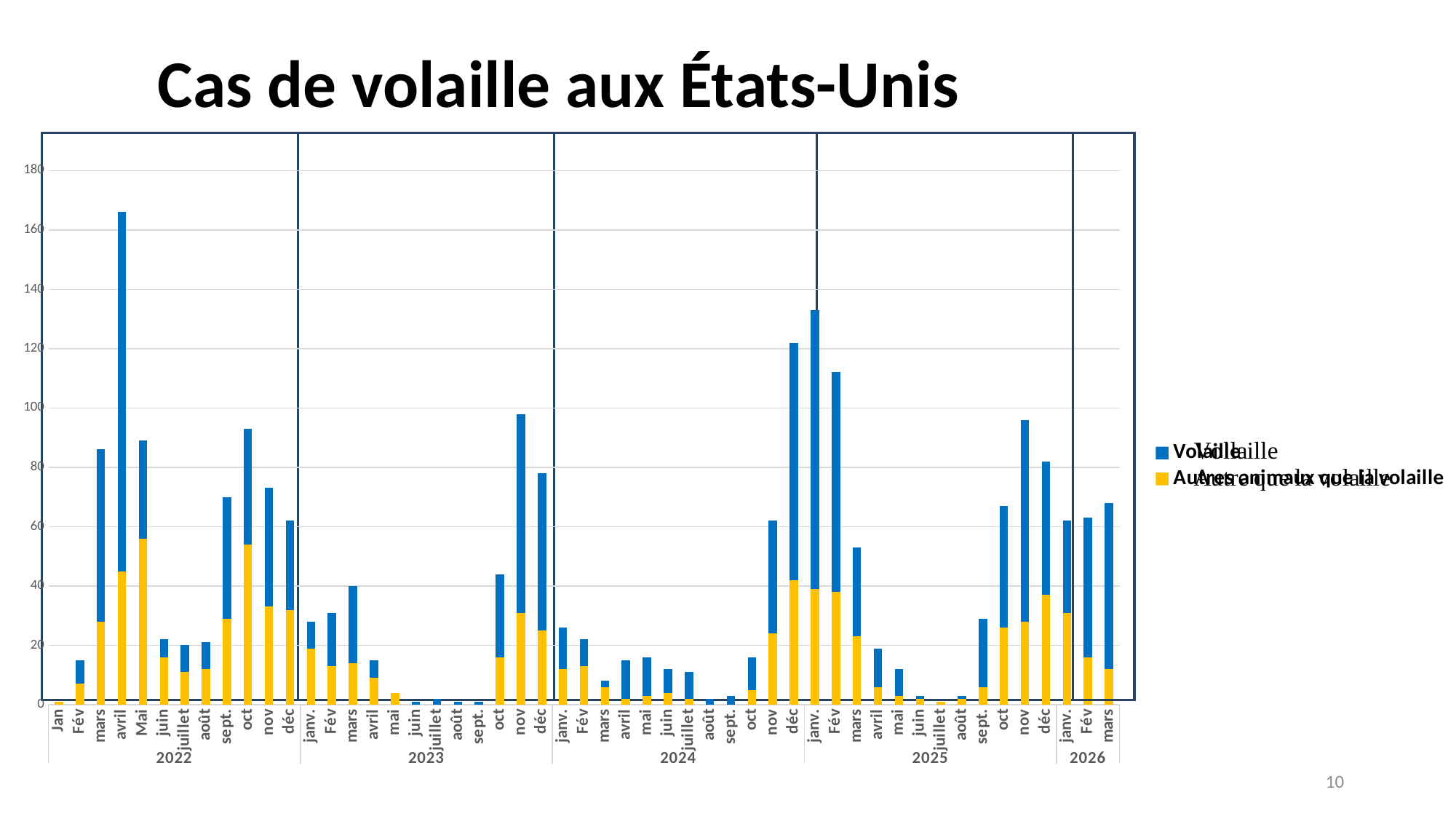
Is the total value for janv. 2025 greater or less than 120? greater What is the title of the chart? Cas de volaille aux États-Unis Which month has the highest total bar in the chart? avril 2022 Which colour represents the 'Volaille' series? Blue How many series does the legend list? 2 Which has the larger total bar, nov 2023 or déc 2023? nov 2023 Which has the larger total bar, Fév 2025 or mars 2025? Fév 2025 Do the total values rise or fall from janv. 2025 to août 2025? Fall Is the total value for nov 2023 greater or less than 80? greater What kind of chart is shown on the slide? Stacked bar chart Is the total value for avril 2022 greater or less than 140? greater How many years are labelled on the x axis? 5